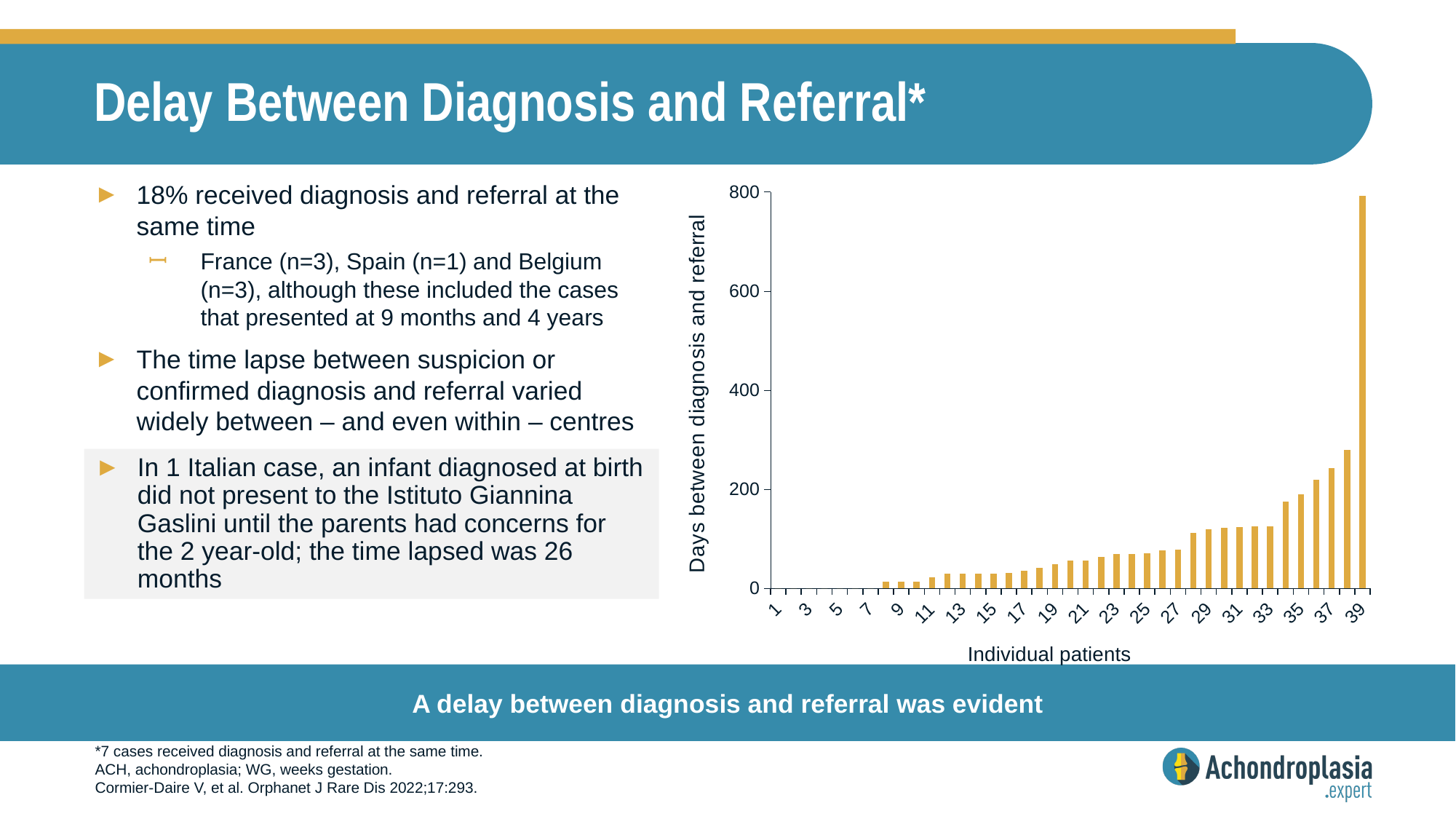
Which individual patient has the highest number of days between diagnosis and referral? 39 Is the value for patient 38 greater or less than 400? less Is the value for patient 37 greater or less than 200? greater Do the values generally rise or fall from patient 1 to patient 39 along the x axis? rise Which is larger, the value for patient 39 or the value for patient 38? patient 39 How many individual patients are shown along the x axis? 39 What kind of chart is shown on the slide? bar chart What is the title of the y axis? Days between diagnosis and referral Is the value for patient 20 greater or less than 200? less Which is larger, the value for patient 10 or the value for patient 30? patient 30